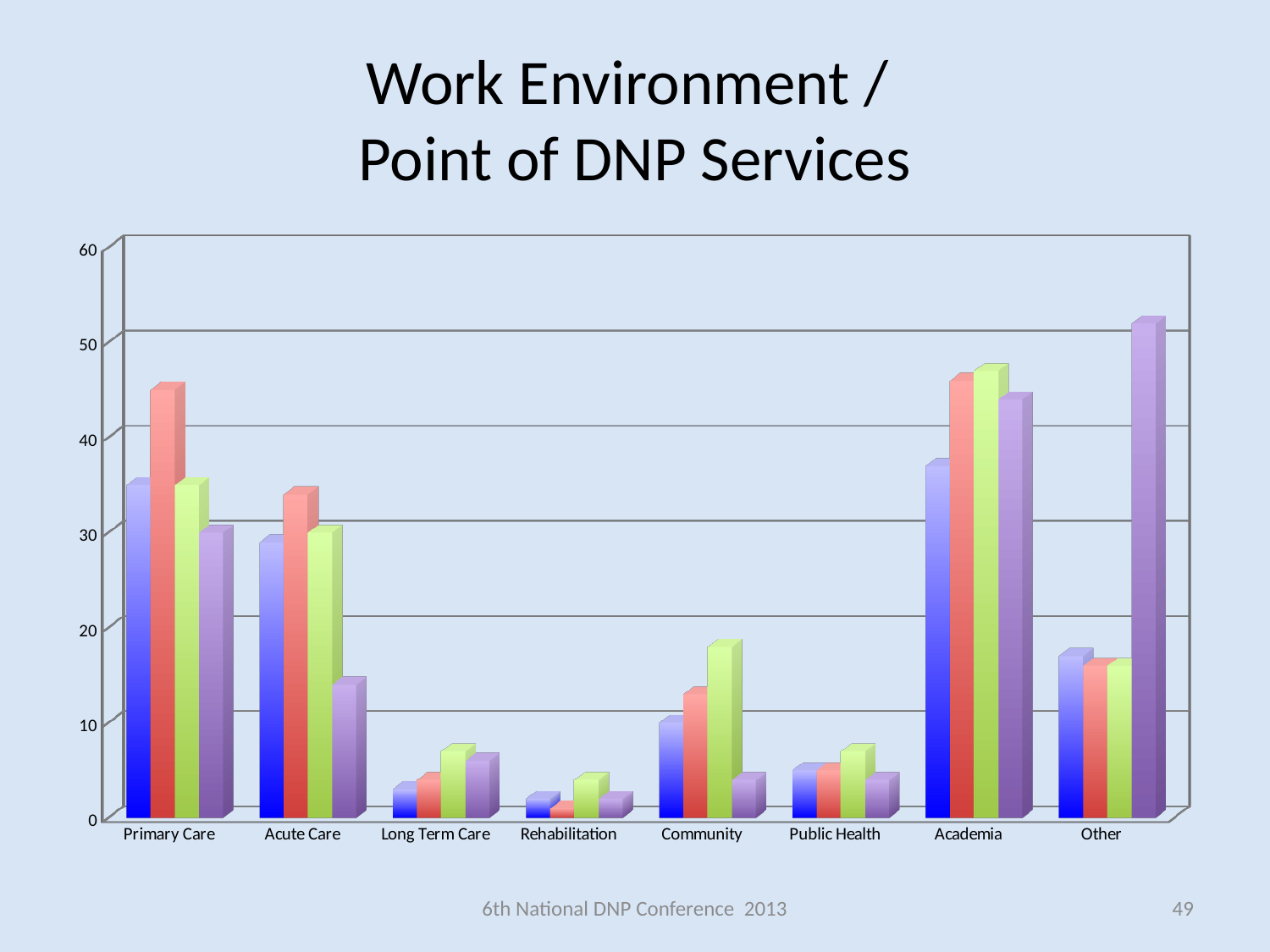
Which is larger: the red bar for Primary Care or the red bar for Acute Care? Primary Care Is the value of the green bar for Public Health greater or less than 10? less How many bars are plotted for each category in the chart? 4 Is the value of the red bar for Primary Care greater or less than 40? greater What kind of chart is shown on the slide? bar chart Which is larger: the green bar for Community or the purple bar for Community? green bar Which category has the lowest bars overall in the chart? Rehabilitation Which category contains the tallest bar in the chart? Other What is the title of the slide containing the chart? Work Environment / Point of DNP Services How many categories are shown along the x axis of the chart? 8 Is the value of the blue bar for Academia greater or less than 30? greater